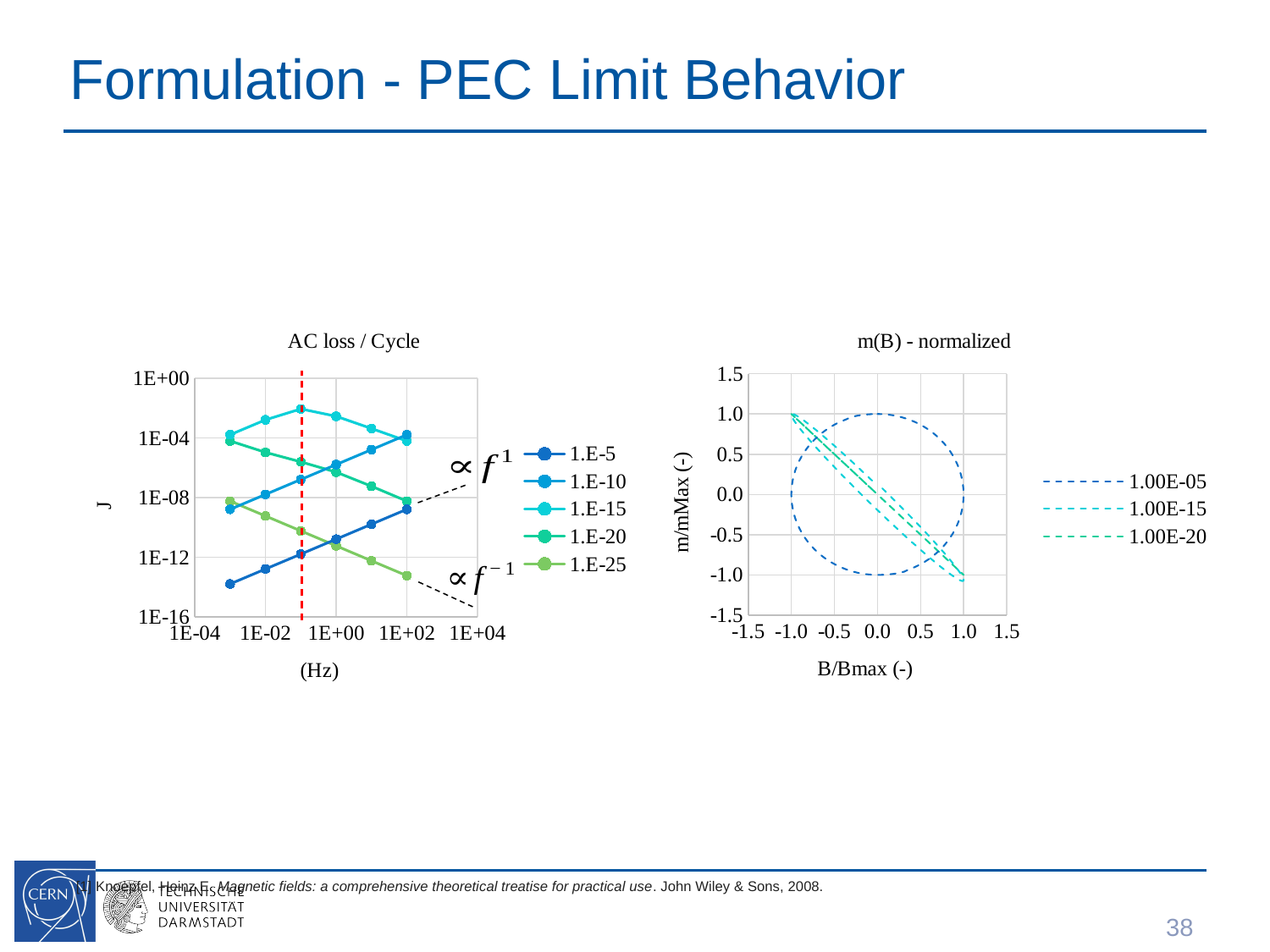
On the m(B) - normalized chart, what is the highest value shown on the y axis? 1.5 On the AC loss / Cycle chart, what is the lowest value shown on the y axis? 1E-16 On the AC loss / Cycle chart, is the value of the 1.E-15 series at 1E-01 Hz greater or less than 1E-04? greater On the AC loss / Cycle chart, which series has the highest value at 1E-01 Hz? 1.E-15 On the AC loss / Cycle chart, what is the highest frequency value shown on the x axis? 1E+04 On the AC loss / Cycle chart, how many series does the legend list? 5 What is the x-axis label of the m(B) - normalized chart? B/Bmax (-) On the AC loss / Cycle chart, is the value of the 1.E-25 series at 1E+02 Hz greater or less than 1E-12? less What kind of chart is the AC loss / Cycle chart? Line chart On the AC loss / Cycle chart, does the 1.E-5 series rise or fall as frequency increases along the x axis? Rise On the m(B) - normalized chart, how many series does the legend list? 3 On the AC loss / Cycle chart, does the 1.E-25 series rise or fall as frequency increases along the x axis? Fall